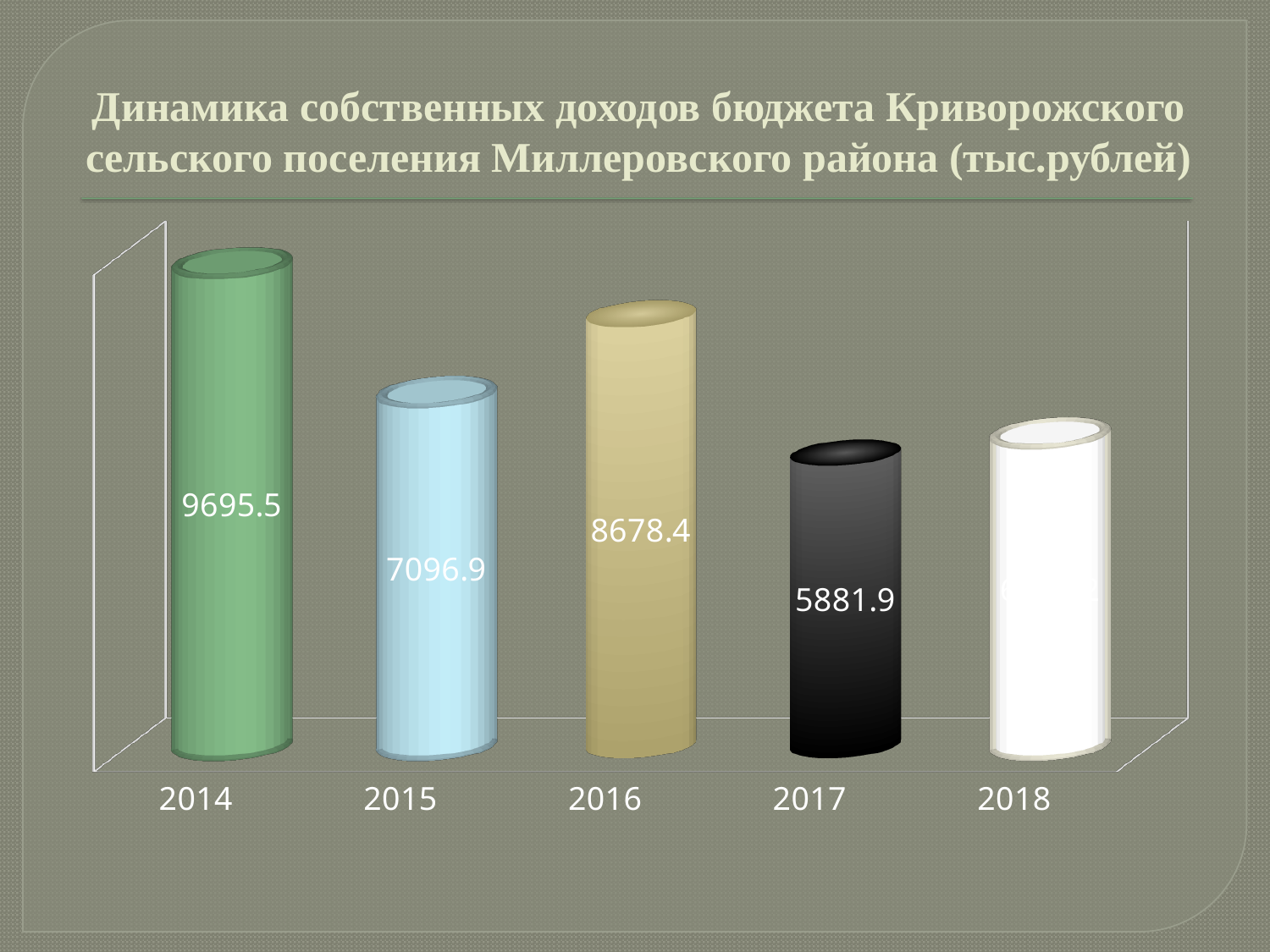
Did the value rise or fall from 2014 to 2015? fall Which year has the highest value? 2014 What is the value for 2015? 7096.9 What colour is the bar for 2014? green What is the value for 2014? 9695.5 What is the difference between the values for 2014 and 2015? 2598.6 Which is larger, the value for 2015 or the value for 2016? 2016 What kind of chart is shown on the slide? bar chart What is the value for 2016? 8678.4 How many years are shown on the x axis? 5 What is the value for 2017? 5881.9 What is the difference between the values for 2016 and 2017? 2796.5